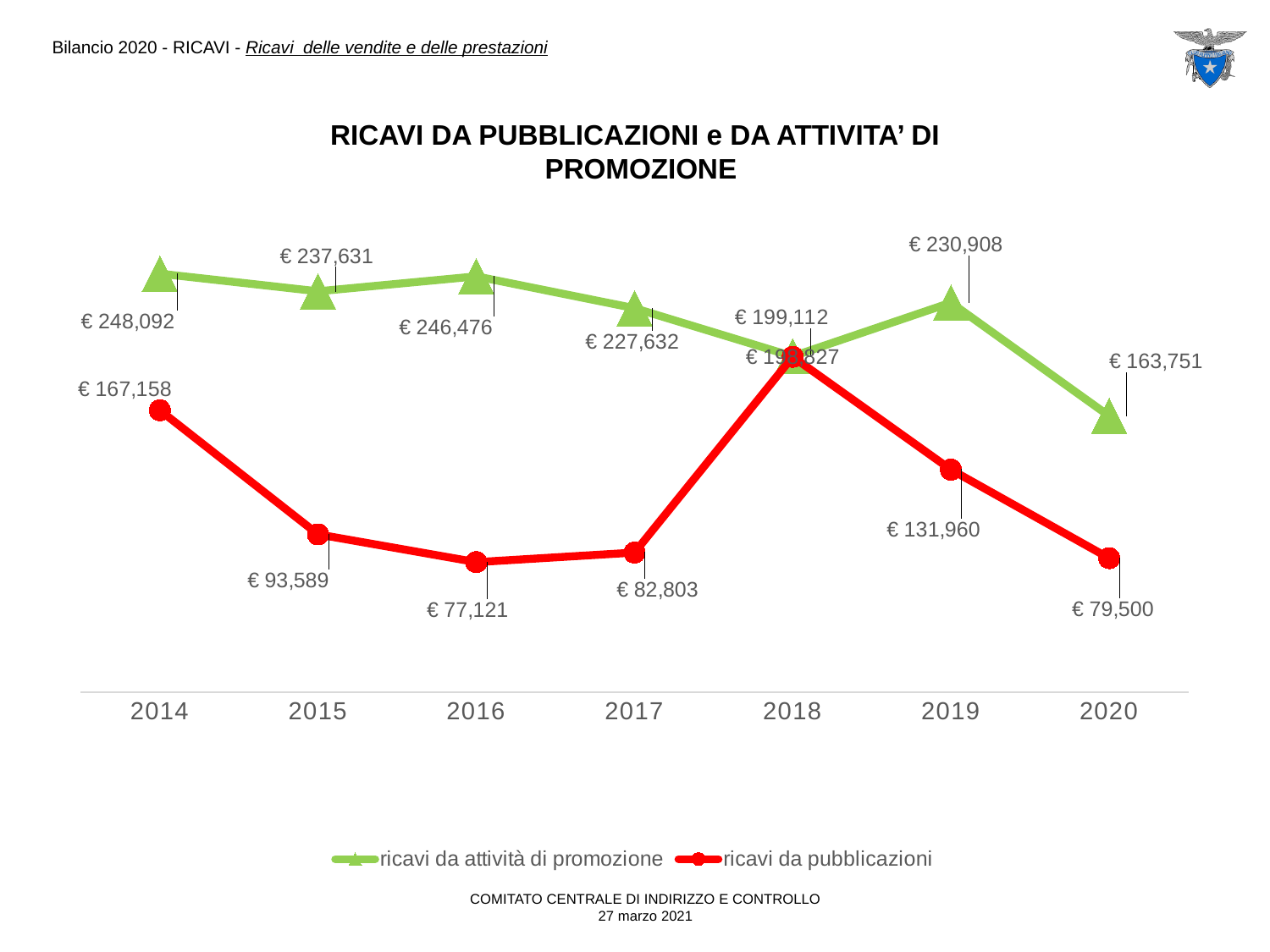
What is the difference between ricavi da attività di promozione in 2019 and in 2020? € 67,157 What is the difference between ricavi da pubblicazioni in 2014 and in 2015? € 73,569 How many series does the legend list? 2 What is the value of ricavi da pubblicazioni in 2019? € 131,960 What is the value of ricavi da attività di promozione in 2020? € 163,751 What kind of chart is shown on the slide? line chart In which year is ricavi da pubblicazioni lowest? 2016 In which year is ricavi da attività di promozione highest? 2014 What is the value of ricavi da pubblicazioni in 2016? € 77,121 How many years are shown on the x axis? 7 In 2015, which series has the larger value, ricavi da attività di promozione or ricavi da pubblicazioni? ricavi da attività di promozione What is the value of ricavi da attività di promozione in 2014? € 248,092